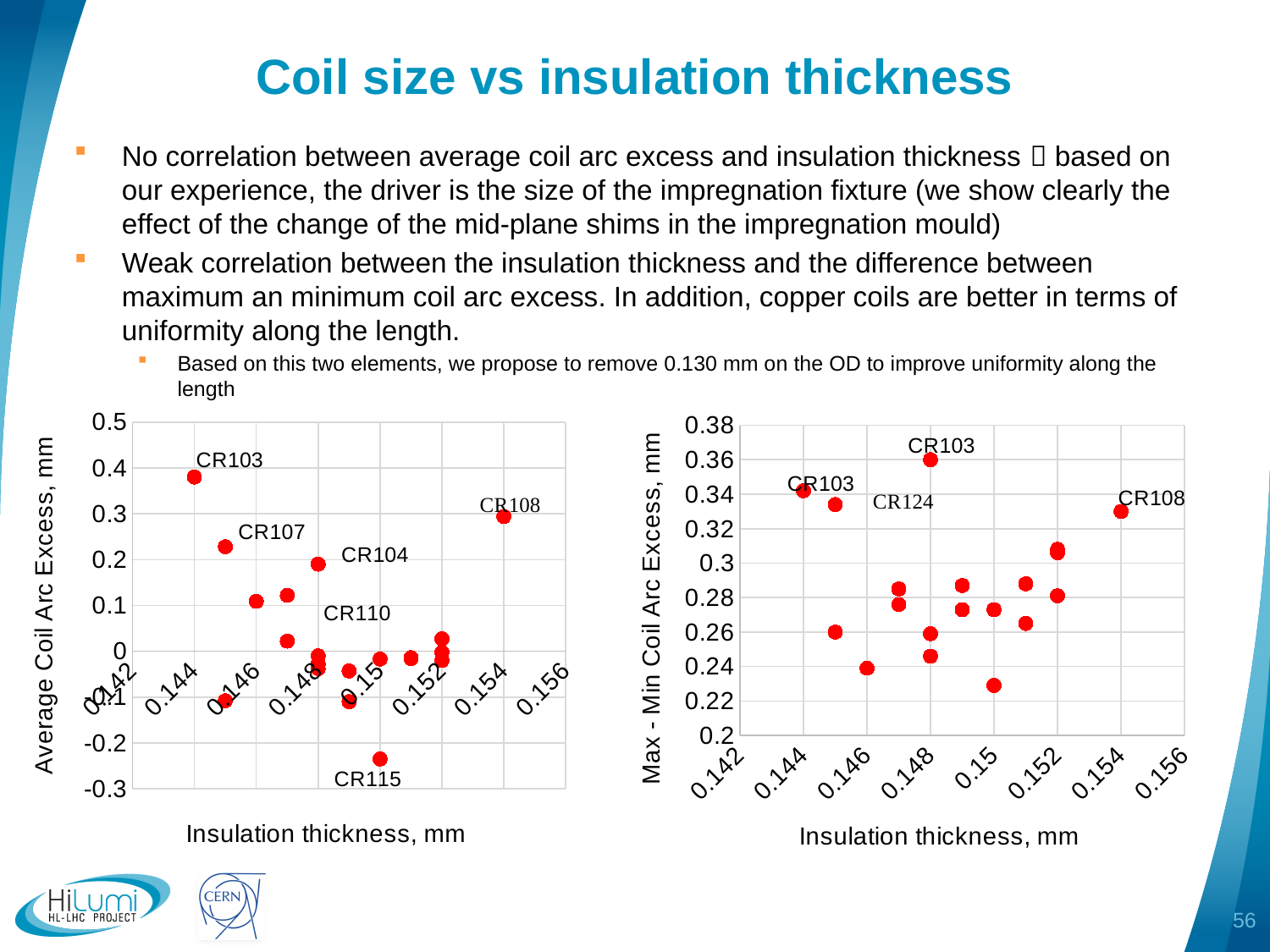
In the left chart, is the average coil arc excess for CR103 greater or less than 0.3? greater In the left chart, which labelled coil has the lowest average coil arc excess? CR115 What is the y-axis title of the right chart? Max - Min Coil Arc Excess, mm In the right chart (Max - Min Coil Arc Excess), which labelled coil has the highest value? CR103 In the left chart, which labelled coil has the highest average coil arc excess? CR103 How many charts are shown on the slide? 2 In the left chart, which has a larger average coil arc excess, CR103 or CR108? CR103 What kind of chart is the left chart (Average Coil Arc Excess vs insulation thickness)? Scatter chart In the right chart, is the Max - Min coil arc excess for CR108 greater or less than 0.3? greater What is the x-axis title of the right chart? Insulation thickness, mm In the left chart, is the average coil arc excess for CR115 greater or less than -0.2? less